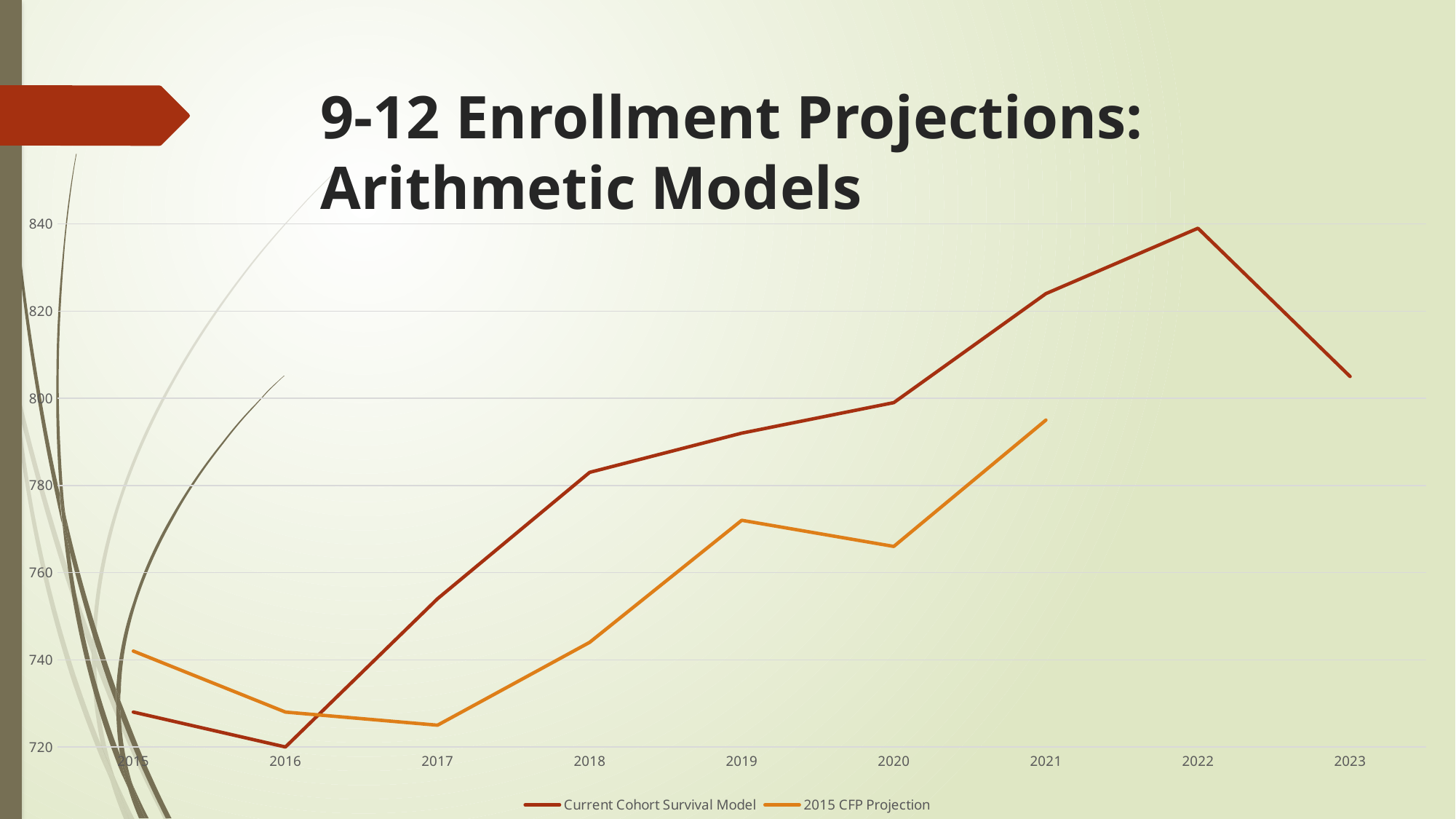
Is the value for the Current Cohort Survival Model in 2022 greater or less than 820? greater Which series has the higher value in 2015, the Current Cohort Survival Model or the 2015 CFP Projection? 2015 CFP Projection In which year does the Current Cohort Survival Model reach its lowest value? 2016 How many series does the legend list? 2 What kind of chart is shown on the slide? line chart In which year does the Current Cohort Survival Model reach its highest value? 2022 What is the title of the slide containing the chart? 9-12 Enrollment Projections: Arithmetic Models Which series has the higher value in 2018, the Current Cohort Survival Model or the 2015 CFP Projection? Current Cohort Survival Model How many years are shown on the x axis? 9 In which year does the 2015 CFP Projection reach its highest value? 2021 Does the Current Cohort Survival Model rise or fall between 2016 and 2022? rise Is the value for the 2015 CFP Projection in 2019 greater or less than 780? less